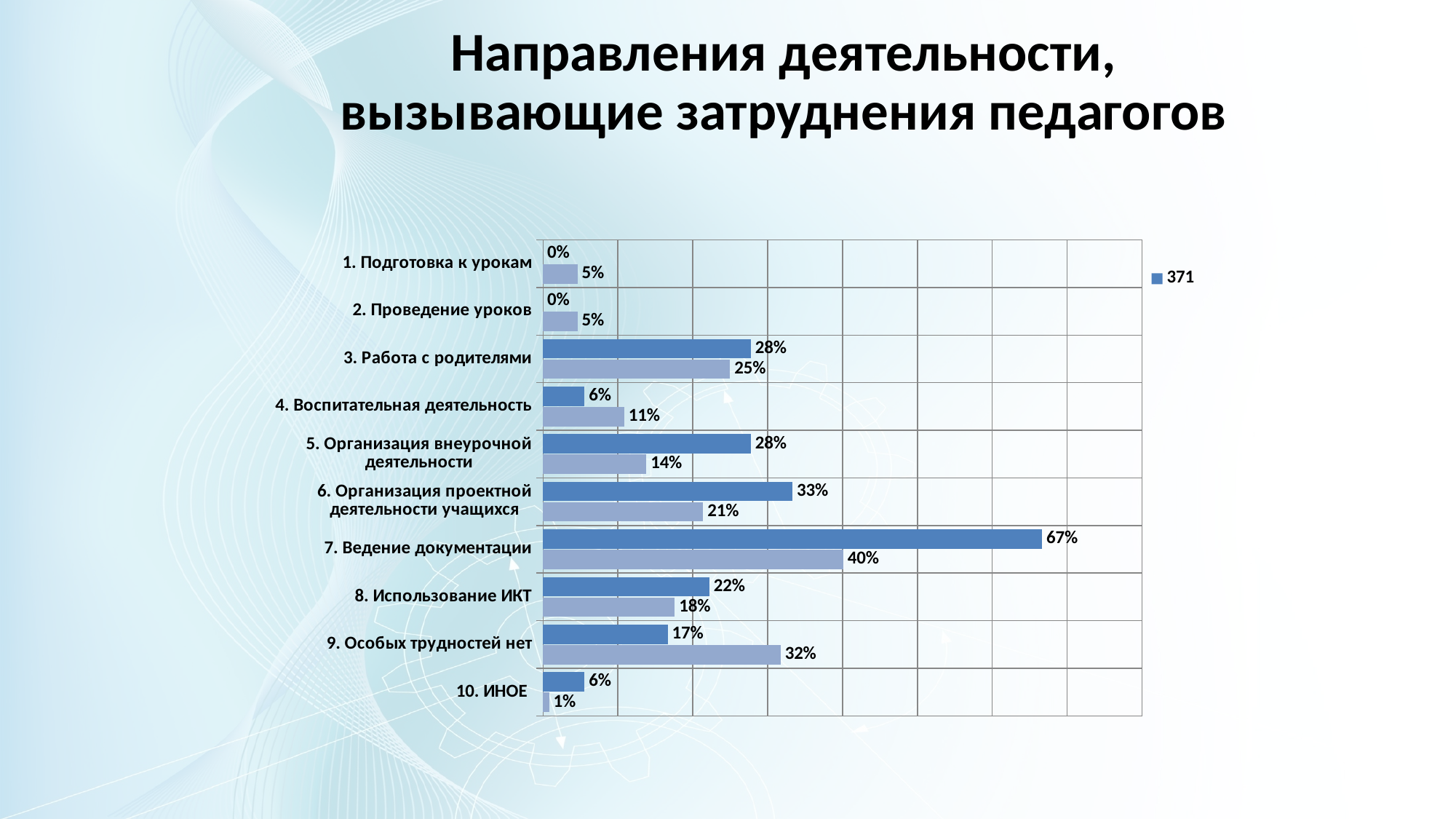
What is the value of the light blue bar for '9. Особых трудностей нет'? 32% What is the value of the dark blue bar for '7. Ведение документации'? 67% Which category has the lowest light blue bar value? 10. ИНОЕ What is the difference between the dark blue values for '5. Организация внеурочной деятельности' and '8. Использование ИКТ'? 6% Which category has the highest dark blue bar value? 7. Ведение документации What is the difference between the dark blue and light blue values for '7. Ведение документации'? 27% What is the only entry shown in the chart's legend? 371 What is the value of the light blue bar for '4. Воспитательная деятельность'? 11% What type of chart is shown on the slide? bar chart For '9. Особых трудностей нет', which bar is larger, the dark blue or the light blue? light blue How many categories are plotted on the chart? 10 What is the value of the dark blue bar for '6. Организация проектной деятельности учащихся'? 33%